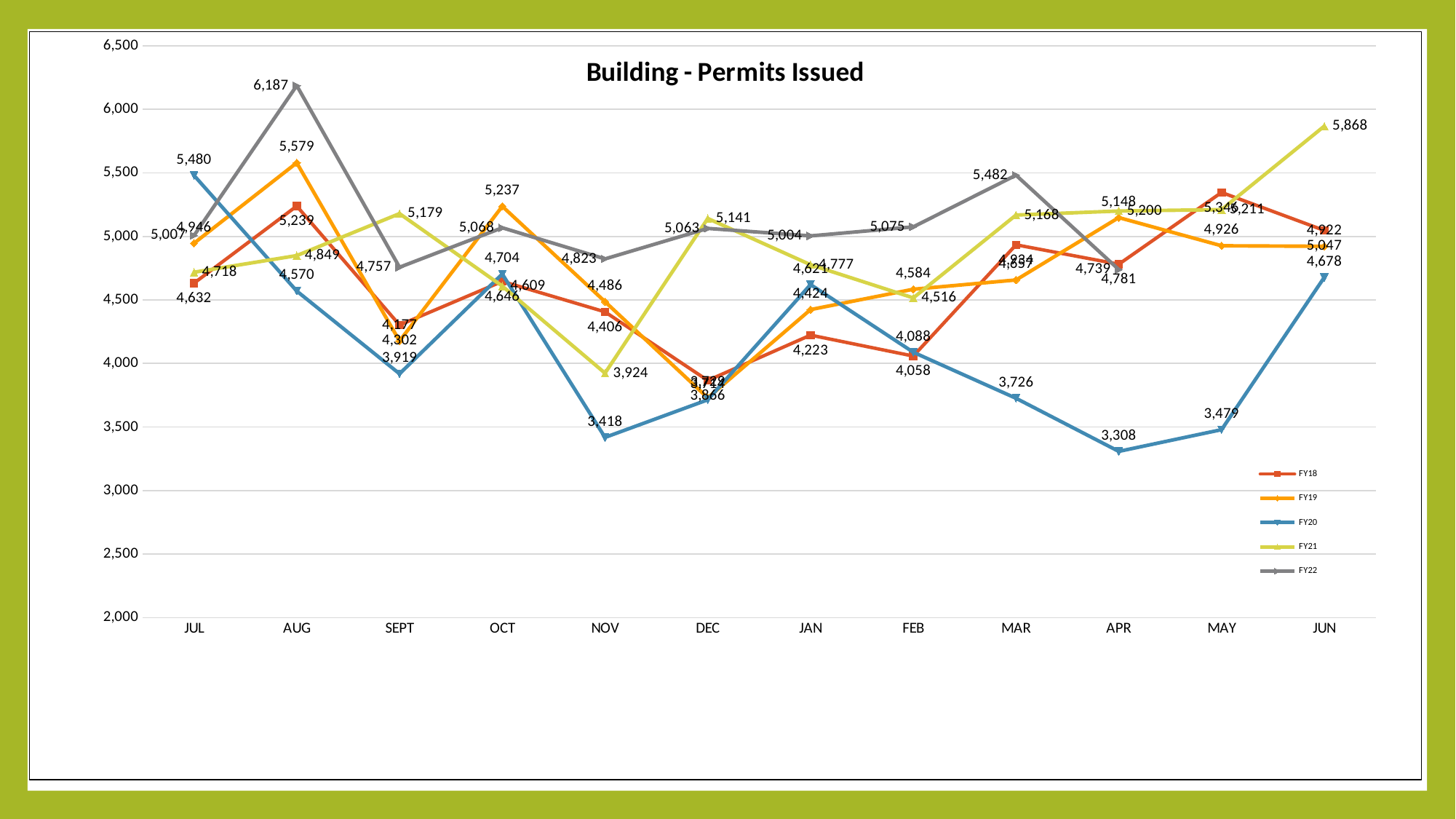
In which month does the FY20 series reach its lowest value? APR What is the FY20 value for APR? 3,308 What is the FY21 value for JUN? 5,868 Does the FY20 series rise or fall from MAR to APR? fall Which series has the larger value in JUN, FY21 or FY20? FY21 How many months are shown on the x axis of the chart? 12 What kind of chart is shown on the slide? line chart How many series does the legend of the 'Building - Permits Issued' chart list? 5 What is the difference between the FY20 values for JUL (5,480) and AUG (4,570)? 910 What is the FY20 value for NOV? 3,418 In which month does the FY22 series reach its highest value? AUG What is the FY22 value for AUG? 6,187